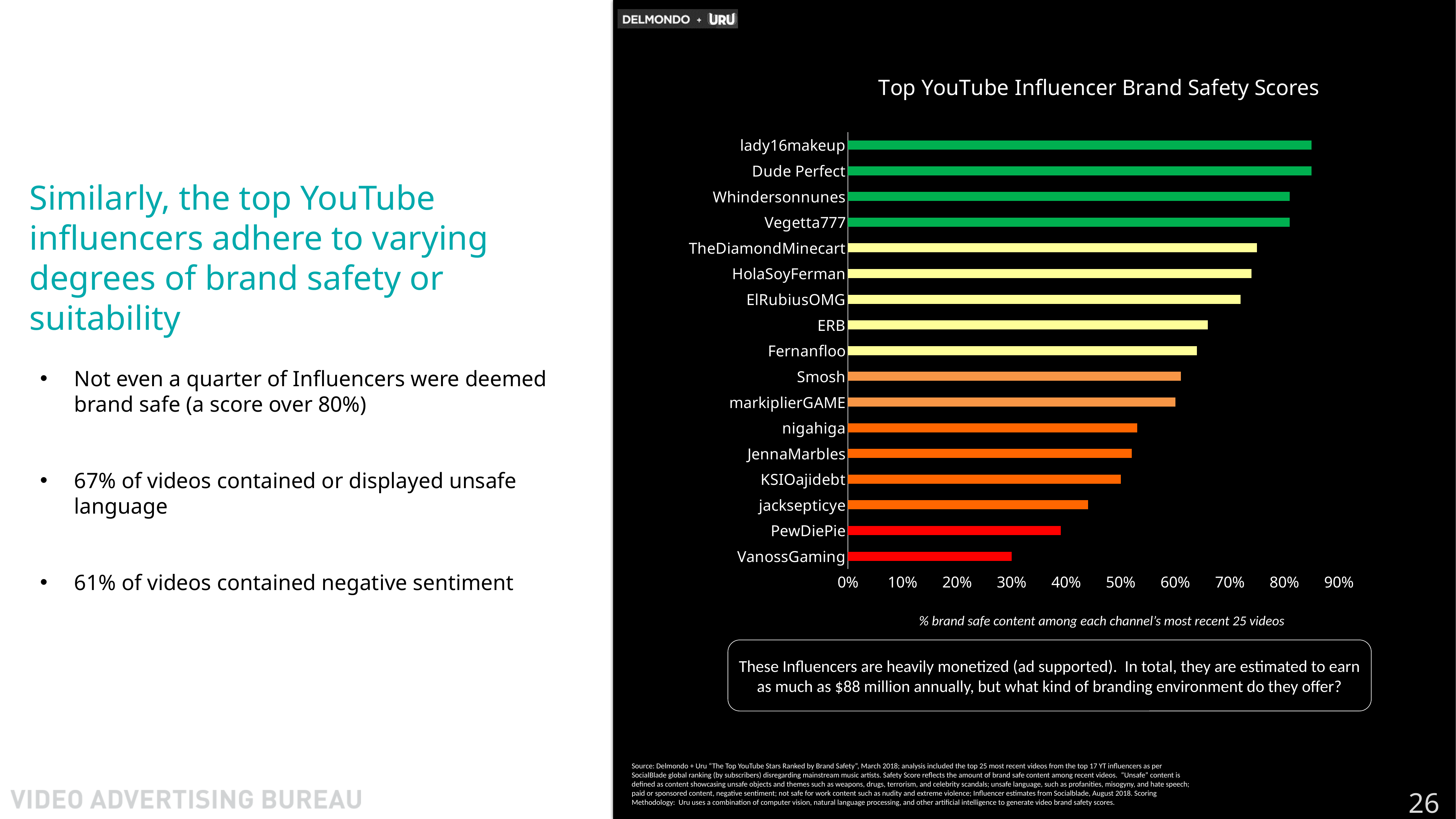
Is the value for VanossGaming greater or less than 40%? less How many influencers (categories) are plotted in the chart? 17 Is the value for lady16makeup greater or less than 80%? greater Which influencer has the lowest brand safety score in the chart? VanossGaming Which has a higher brand safety score, Fernanfloo or PewDiePie? Fernanfloo Is the value for TheDiamondMinecart greater or less than 70%? greater What kind of chart is shown on the slide? bar chart Do the bar values increase or decrease going from the top of the chart to the bottom? decrease What is the title of the chart? Top YouTube Influencer Brand Safety Scores Which has a higher brand safety score, nigahiga or Whindersonnunes? Whindersonnunes